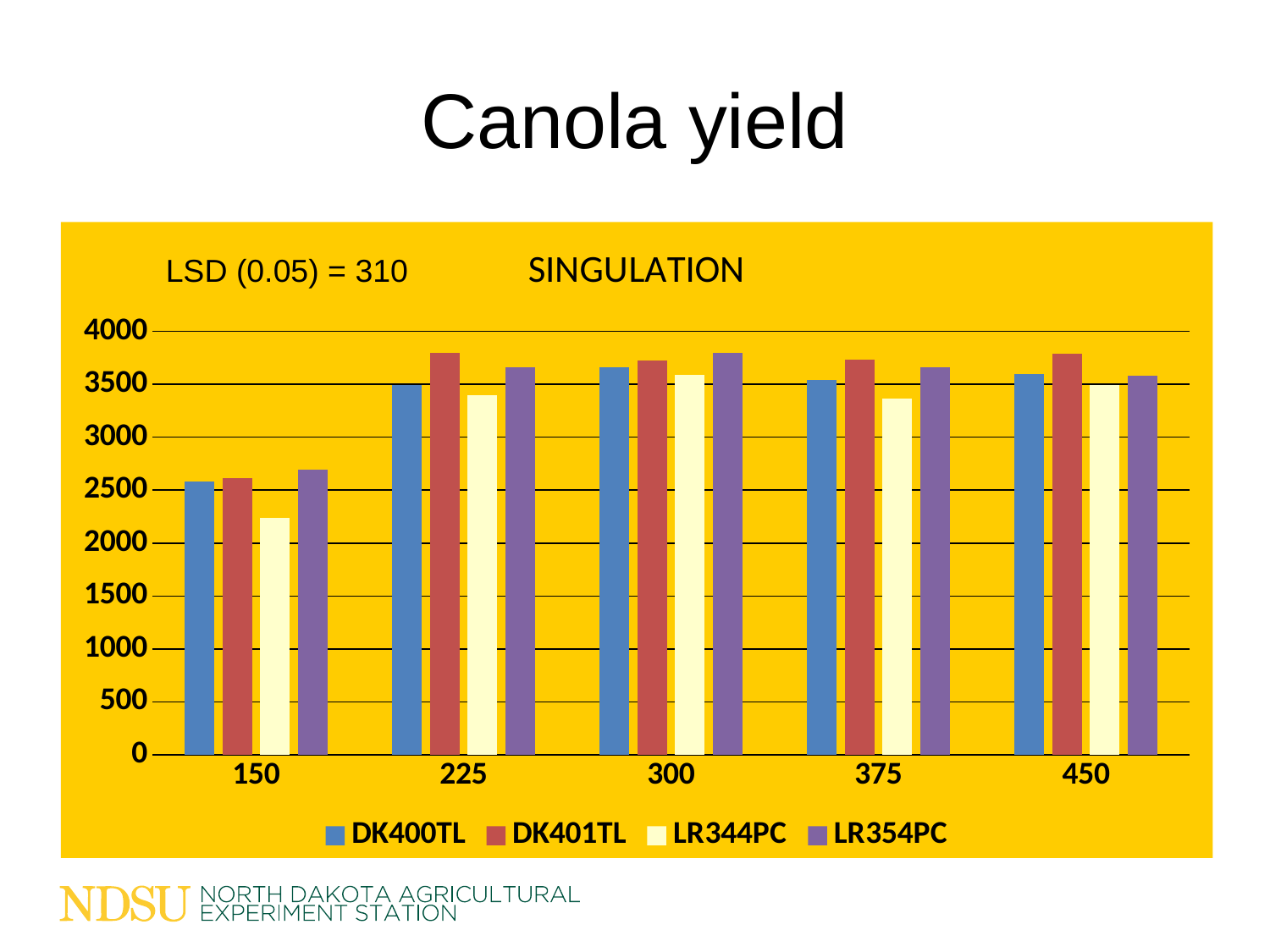
Is the value for LR344PC at 150 greater or less than 2500? less Does the DK400TL value rise or fall from 150 to 225? rise How many series does the legend list? 4 How many categories are shown on the x axis of the chart? 5 What LSD (0.05) value is printed on the chart? 310 Which series has the highest value at the 150 category? LR354PC At the 225 category, which is larger: DK401TL or LR344PC? DK401TL What kind of chart is shown on the slide? bar chart Which x-axis category has the lowest yields overall? 150 Which series has the lowest value at the 150 category? LR344PC Is the value for LR344PC at 375 greater or less than 3500? less Is the value for DK401TL at 225 greater or less than 3500? greater